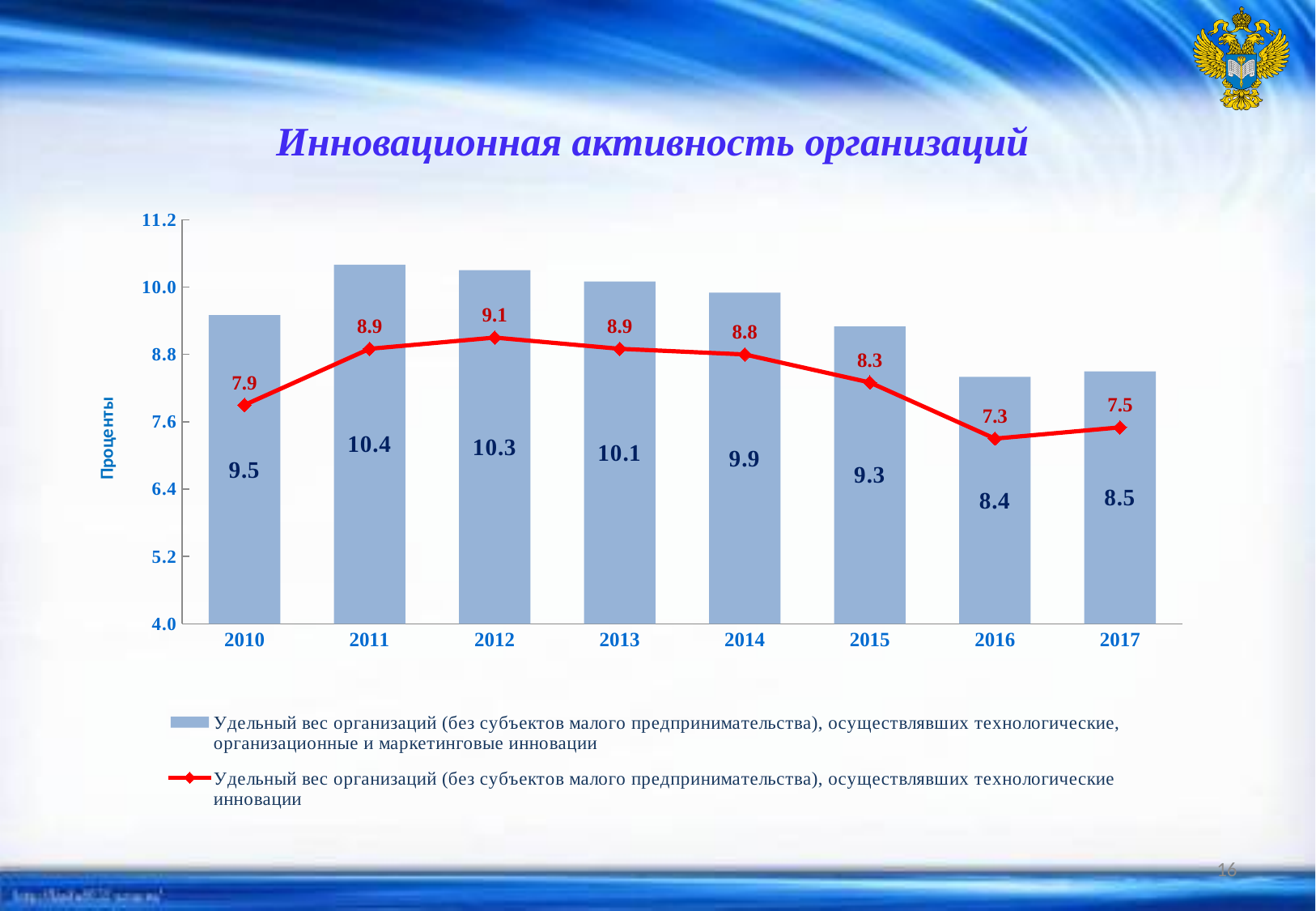
In which year is the red line series at its lowest? 2016 What is the difference between the bar value and the line value for 2010? 1.6 What kind of chart is shown on the slide? Combined bar and line chart In which year is the bar series at its highest? 2011 What is the difference between the bar value for 2011 and the bar value for 2016? 2.0 What is the value of the bar series for 2017? 8.5 What is the value of the red line series (technological innovations) for 2012? 9.1 What is the value of the bar series for 2011? 10.4 How many series does the legend list? 2 Which is larger: the line value for 2013 or the line value for 2014? 2013 What is the title of the chart? Инновационная активность организаций How many years are shown on the x axis? 8